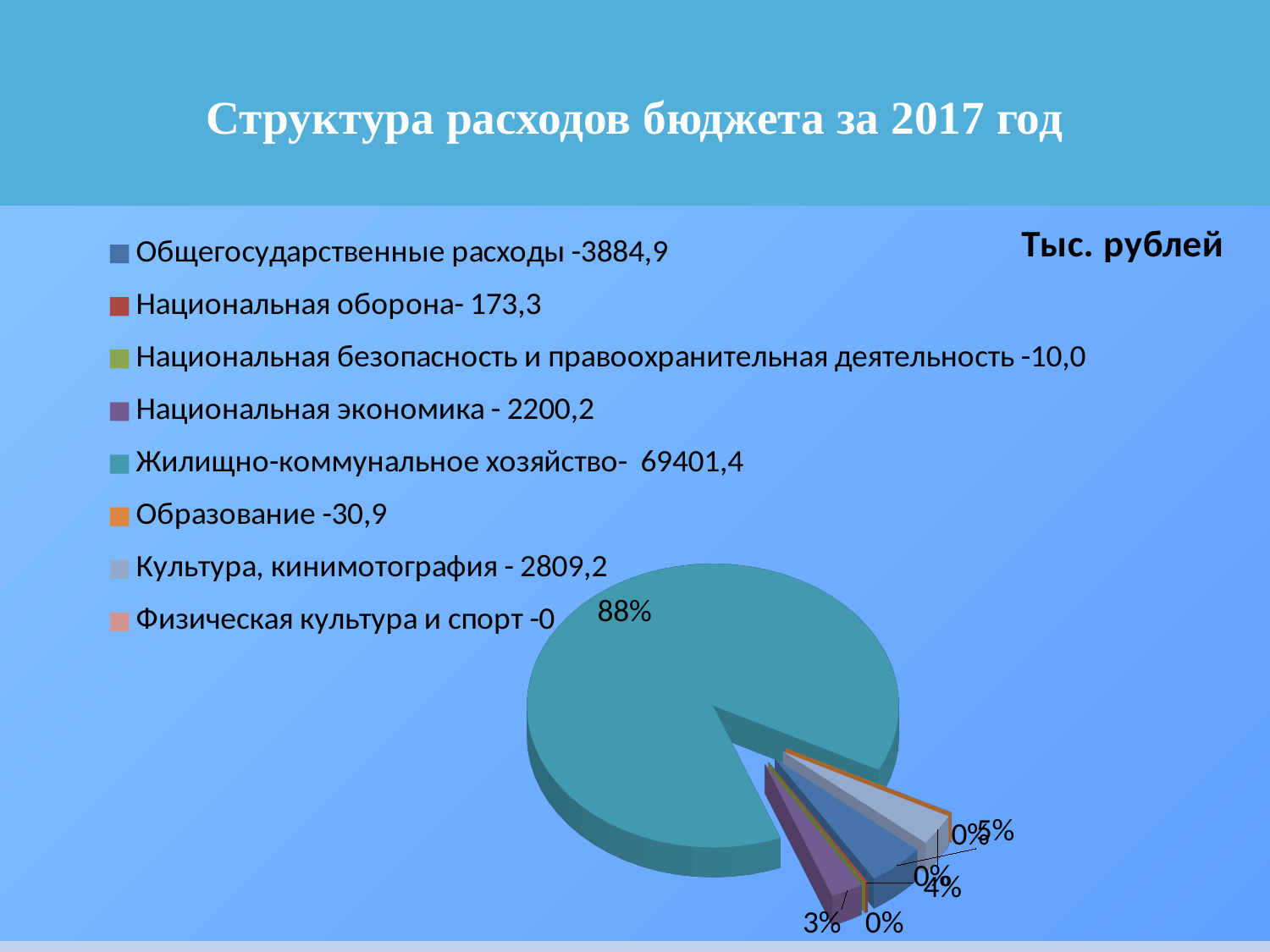
Which category has the largest expenditure? Жилищно-коммунальное хозяйство What is the value for Национальная оборона in the legend? 173,3 Which is larger: Национальная экономика or Культура, кинимотография? Культура, кинимотография What kind of chart is shown on the slide? Pie chart How many categories are listed in the legend? 8 What is the value for Образование in the legend? 30,9 What is the value for Жилищно-коммунальное хозяйство in the legend? 69401,4 What is the value for Культура, кинимотография in the legend? 2809,2 What is the difference between Общегосударственные расходы and Национальная экономика? 1684,7 Which category has the smallest expenditure? Физическая культура и спорт What share of the pie does Жилищно-коммунальное хозяйство take? 88% What unit of measurement is indicated on the slide for the values? Тыс. рублей